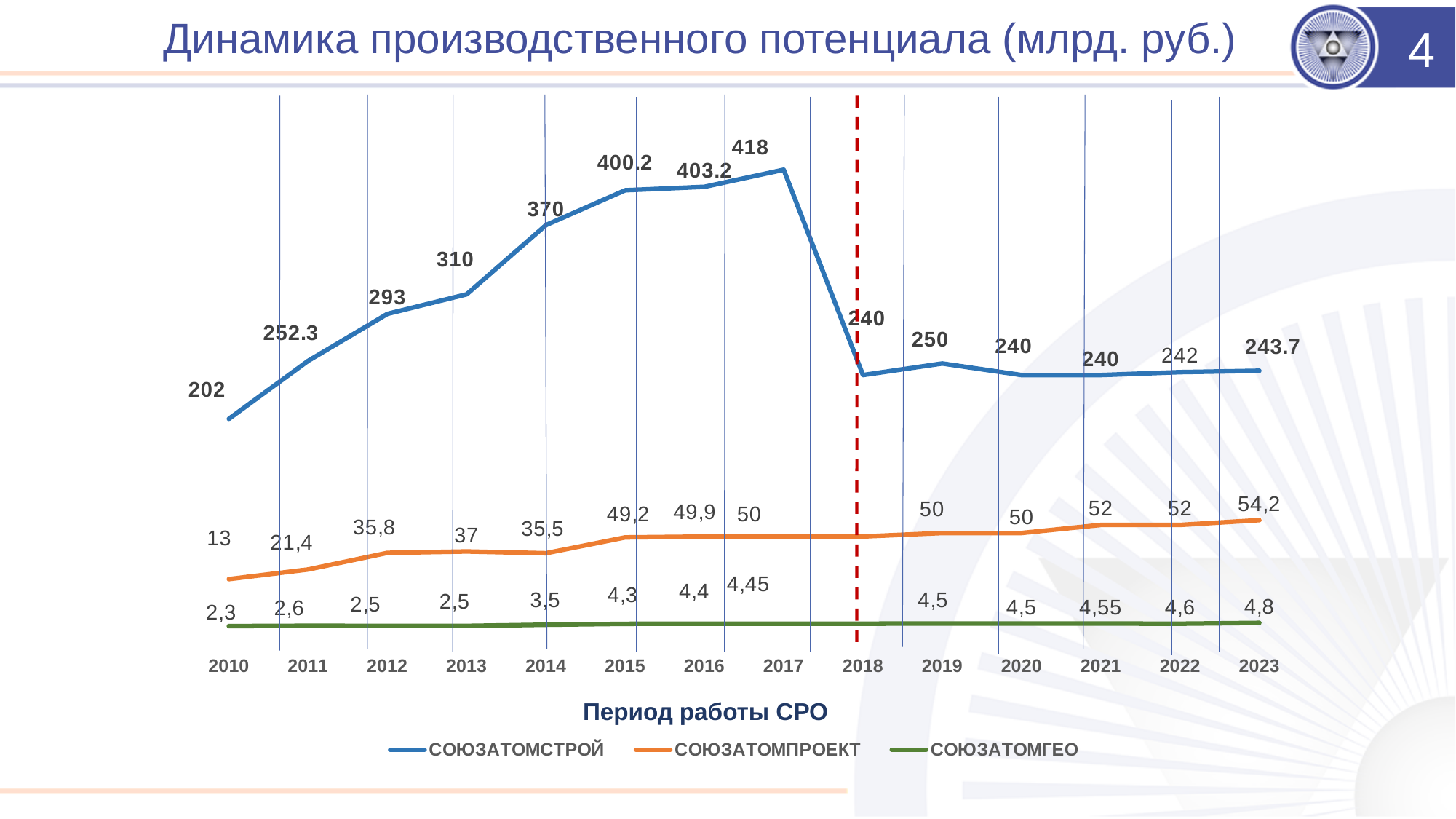
How many years are shown on the x axis? 14 How many series does the legend list? 3 Which is larger: the СОЮЗАТОМСТРОЙ value in 2010 or in 2023? 2023 Does the СОЮЗАТОМСТРОЙ line rise or fall from 2010 to 2017? rise What is the value for СОЮЗАТОМСТРОЙ in 2017? 418 What type of chart is shown on the slide? line chart What is the title of the chart? Динамика производственного потенциала (млрд. руб.) In which year does СОЮЗАТОМСТРОЙ reach its highest value? 2017 In which year does СОЮЗАТОМПРОЕКТ have its lowest value? 2010 What is the difference between the СОЮЗАТОМСТРОЙ values in 2017 and 2018? 178 What is the value for СОЮЗАТОМПРОЕКТ in 2023? 54,2 What is the value for СОЮЗАТОМГЕО in 2014? 3,5